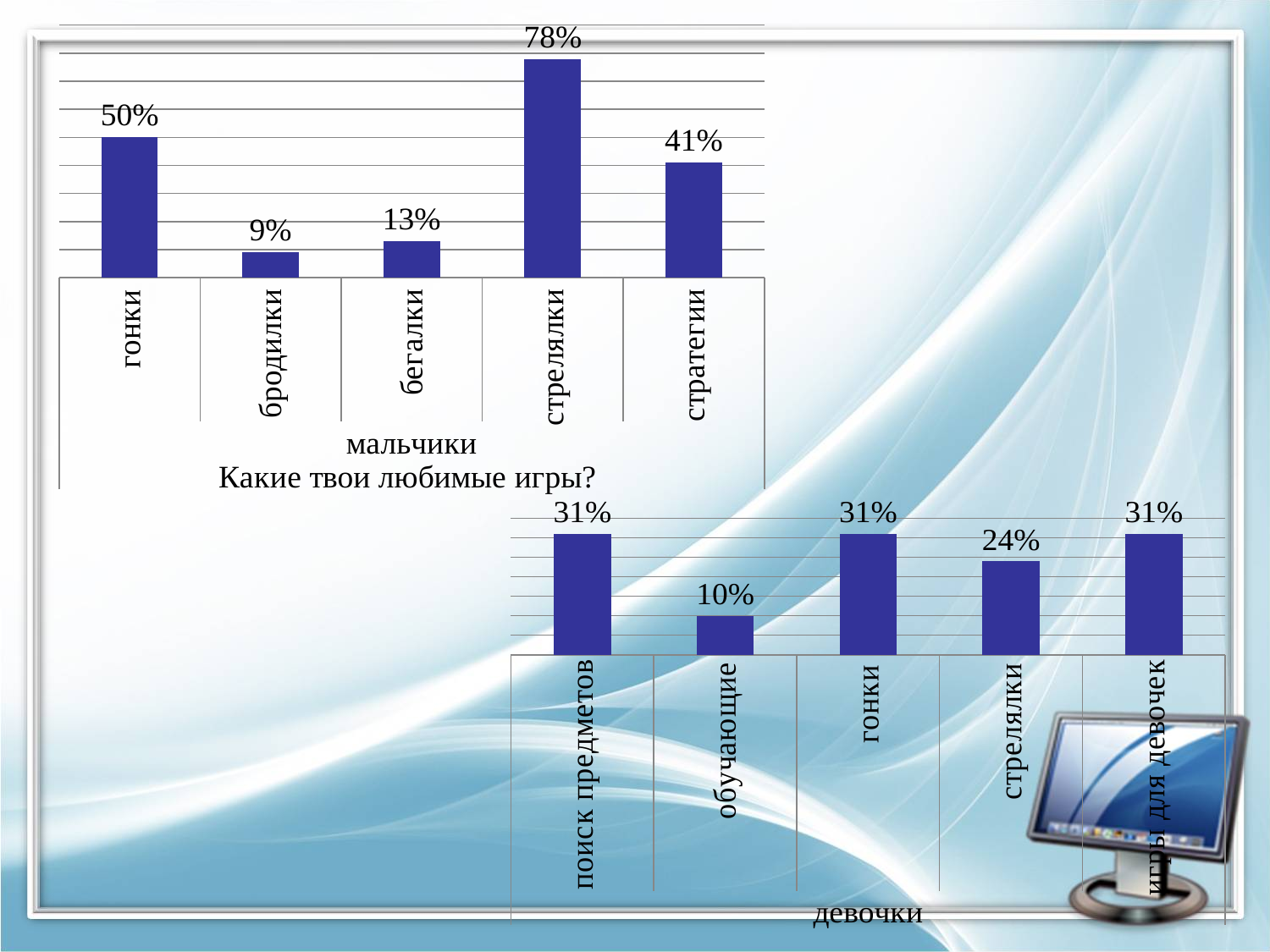
In the bottom chart (девочки), what is the value for обучающие? 10% In the top chart (мальчики), which category has the lowest value? бродилки In the bottom chart (девочки), what is the value for стрелялки? 24% In the top chart (мальчики), what is the value for бродилки? 9% In the bottom chart (девочки), which is larger, the value for гонки or the value for стрелялки? гонки In the top chart (мальчики), what is the value for стрелялки? 78% In the top chart (мальчики), how many categories are shown? 5 What kind of chart is the top chart (мальчики)? bar chart In the bottom chart (девочки), how many categories are shown? 5 In the top chart (мальчики), what is the difference between the values for гонки and стратегии? 9% In the bottom chart (девочки), which category has the lowest value? обучающие In the top chart (мальчики), which category has the highest value? стрелялки